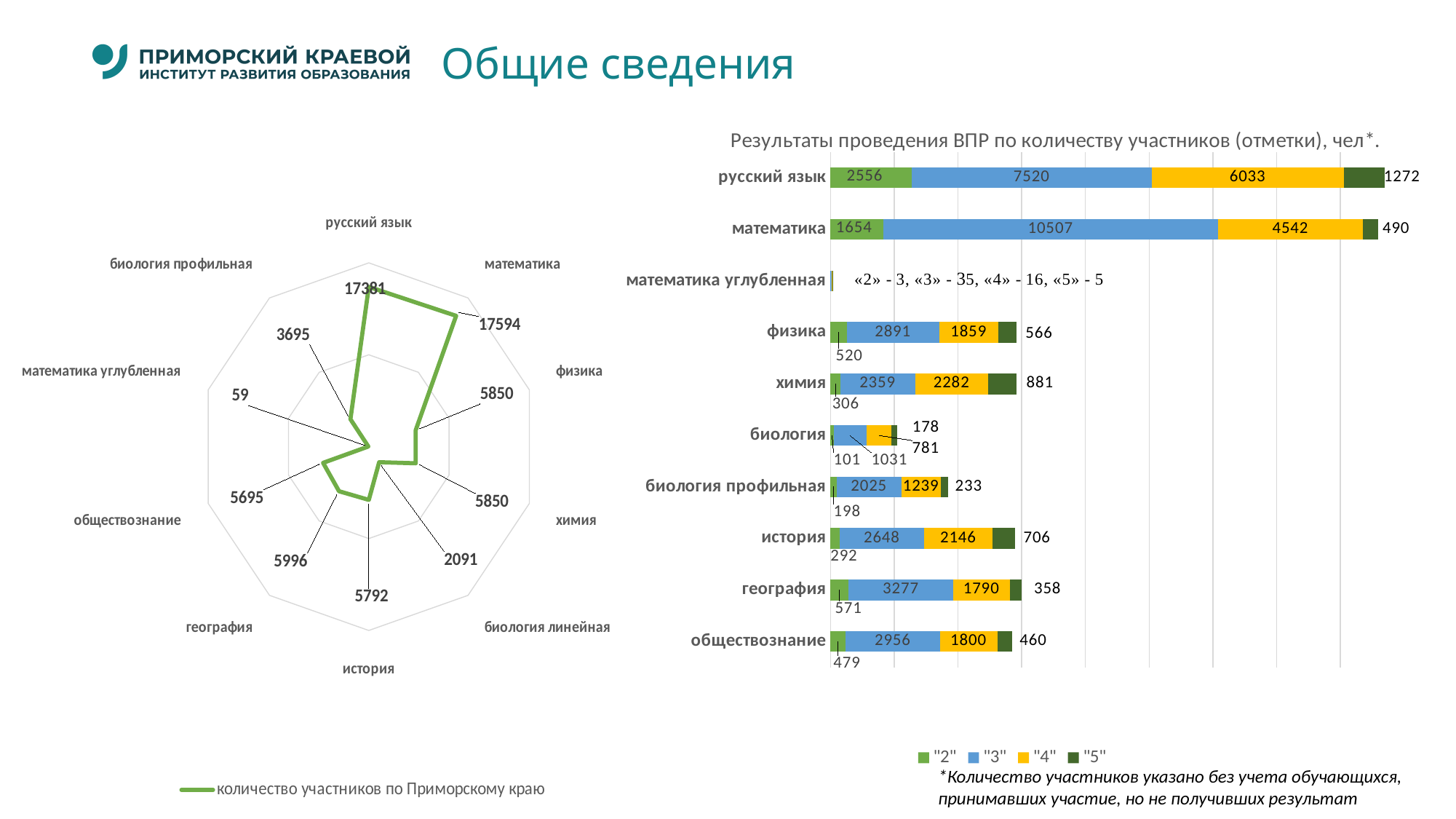
What kind of chart is the chart titled 'Результаты проведения ВПР по количеству участников (отметки), чел*.'? stacked bar chart In the left radar chart, which category has the lowest value? математика углубленная How many series does the legend of the right stacked bar chart list? 4 In the left radar chart, which category has the highest value? математика In the left radar chart, what is the value for математика? 17594 What kind of chart is the chart on the left side of the slide? radar chart In the right stacked bar chart, what is the value of the "5" series for химия? 881 In the left radar chart, what is the difference between the values for география and обществознание? 301 In the right stacked bar chart, which is larger: the "4" value for физика or the "4" value for история? история How many categories does the left radar chart show? 10 In the right stacked bar chart, what is the total of the stacked bar for русский язык? 17381 In the right stacked bar chart, what is the value of the "3" series for математика? 10507